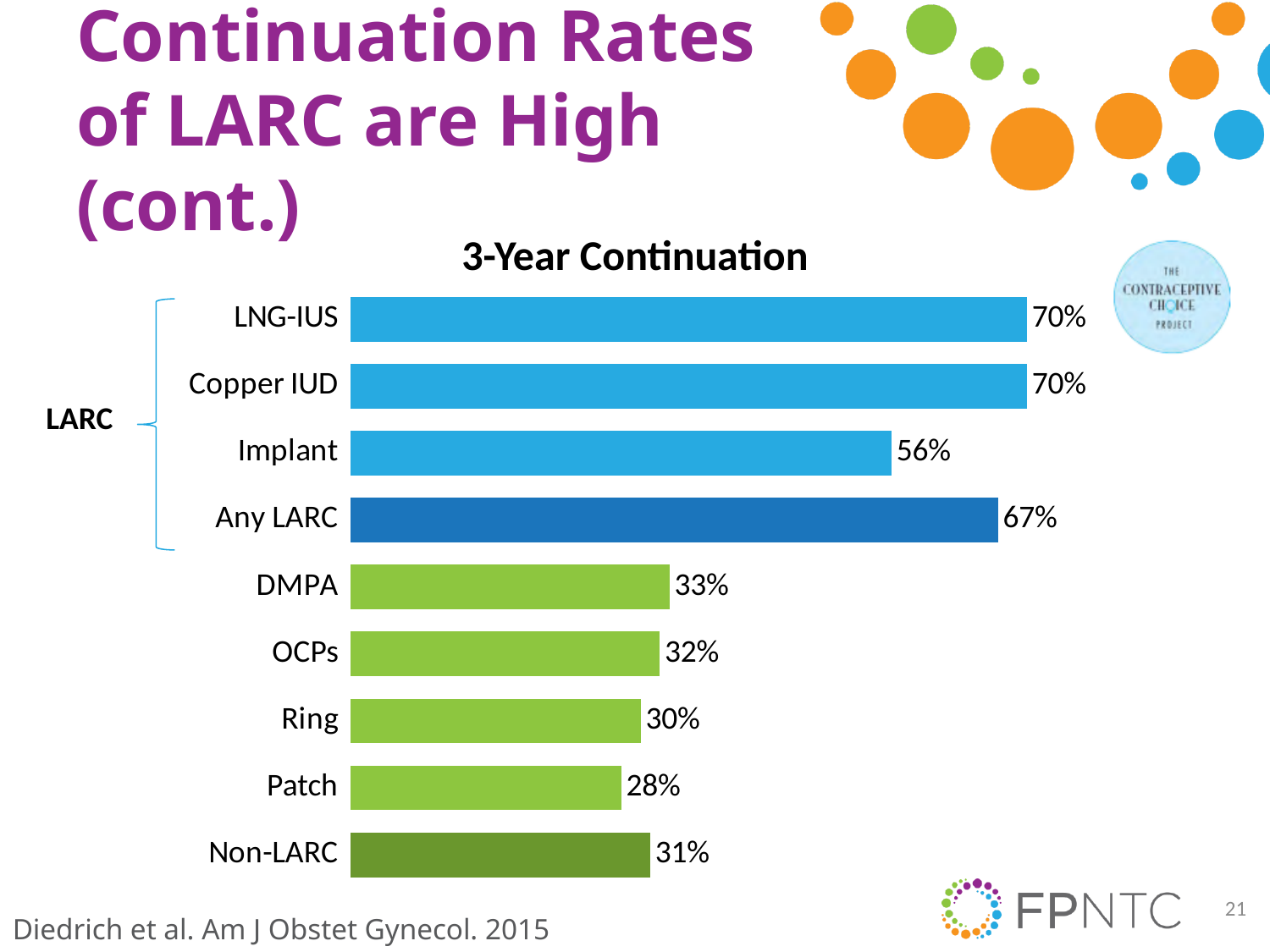
Which has a higher 3-year continuation rate, OCPs or Ring? OCPs What is the 3-year continuation rate for Any LARC? 67% What is the title of the chart? 3-Year Continuation What is the 3-year continuation rate for DMPA? 33% Which category has the lowest 3-year continuation rate? Patch What is the 3-year continuation rate for Implant? 56% What is the 3-year continuation rate for Patch? 28% Which has a higher 3-year continuation rate, Implant or DMPA? Implant What is the difference between the continuation rates for Any LARC and Non-LARC? 36% What is the difference between the continuation rates for LNG-IUS and Implant? 14% What kind of chart is shown on the slide? Bar chart How many categories are shown in the chart? 9